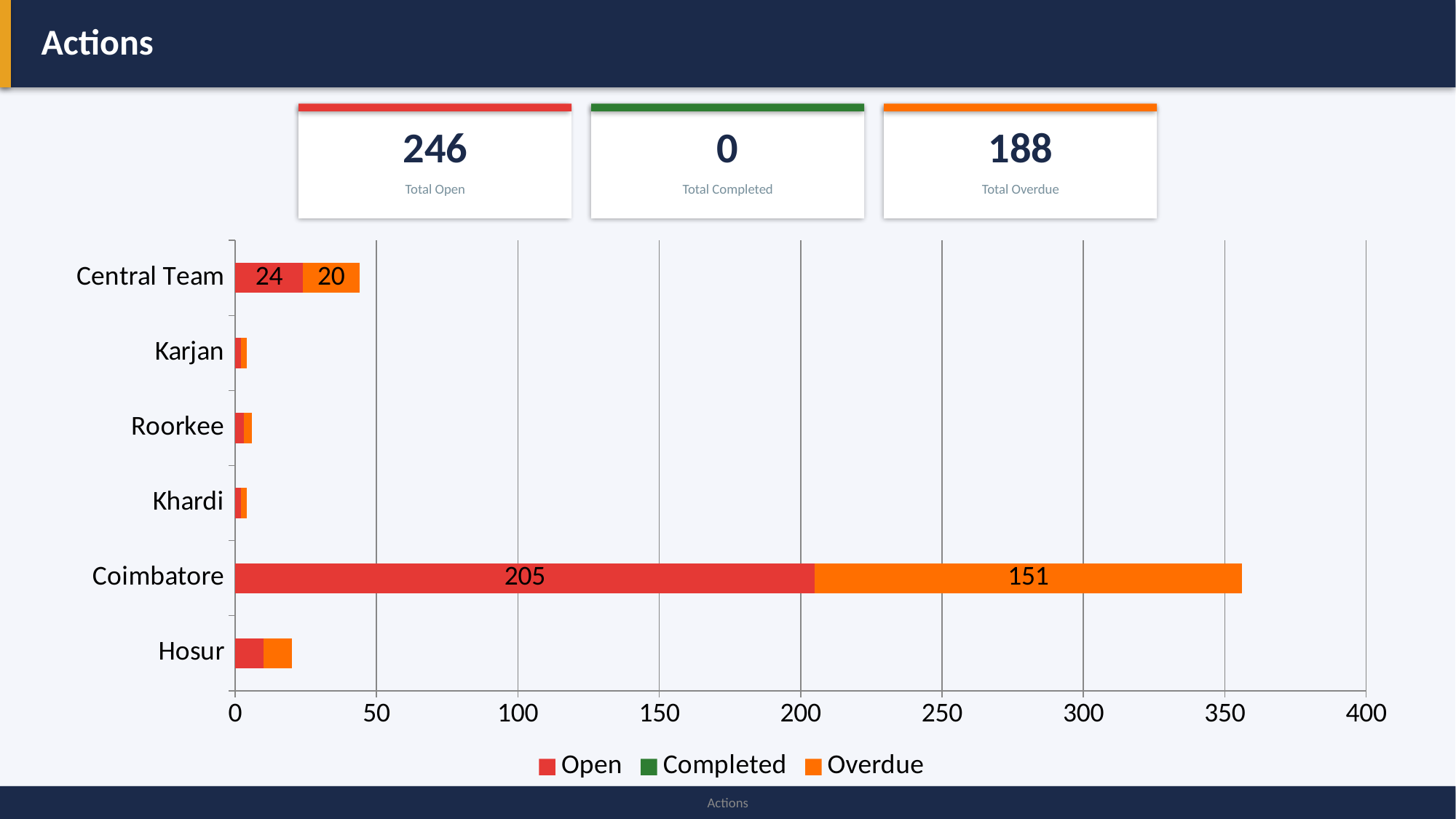
For Central Team, which is larger: the Open value or the Overdue value? Open Which category has the longest bar overall? Coimbatore What is the total of the stacked bar for Central Team? 44 What is the total of the stacked bar for Coimbatore? 356 What is the Overdue value for Central Team? 20 What is the Open value for Coimbatore? 205 What is the Open value for Central Team? 24 What is the difference between the Open and Overdue values for Coimbatore? 54 What is the Overdue value for Coimbatore? 151 How many series does the legend list? 3 Is the total bar length for Hosur greater or less than 50? less How many categories are shown on the chart? 6